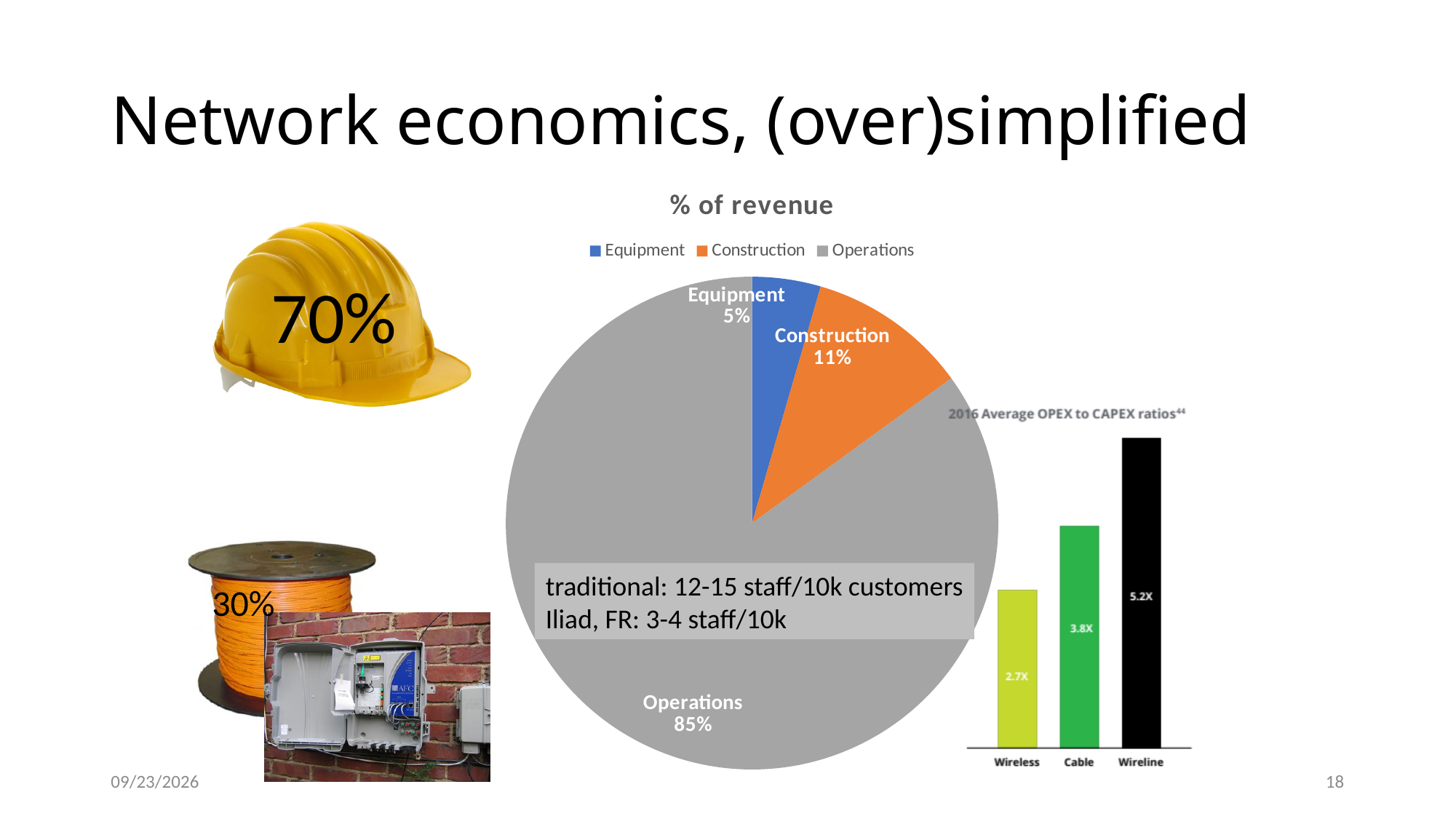
In the '% of revenue' pie chart, what share does Operations have? 85% In the '% of revenue' pie chart, what is the difference between the Construction and Equipment shares? 6% In the '2016 Average OPEX to CAPEX ratios' chart, what is the value for Wireless? 2.7X In the '2016 Average OPEX to CAPEX ratios' chart, what is the value for Cable? 3.8X In the '% of revenue' pie chart, which category has the smallest slice? Equipment In the '2016 Average OPEX to CAPEX ratios' chart, do the values rise or fall from Wireless to Wireline? Rise In the '% of revenue' pie chart, how many entries does the legend list? 3 What kind of chart is the '2016 Average OPEX to CAPEX ratios' chart? Bar chart In the '% of revenue' pie chart, what share does Construction have? 11% In the '% of revenue' pie chart, what share does Equipment have? 5% In the '% of revenue' pie chart, which category has the largest slice? Operations In the '2016 Average OPEX to CAPEX ratios' chart, which category has the highest ratio? Wireline